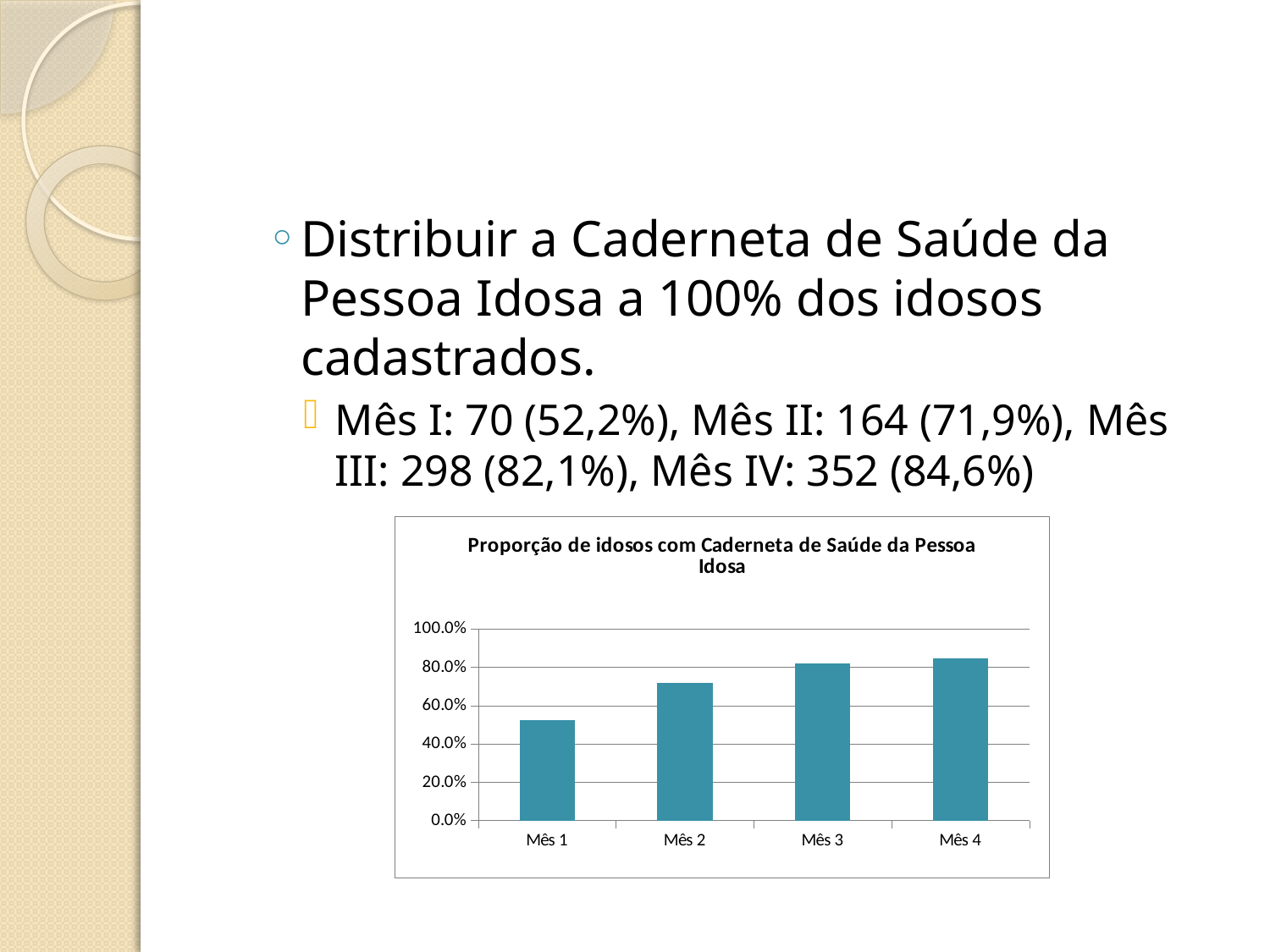
What kind of chart is shown on the slide? bar chart Is the value for Mês 2 greater or less than 60.0%? greater What is the highest value shown on the vertical axis of the chart? 100.0% Is the value for Mês 1 greater or less than 40.0%? greater Is the value for Mês 3 greater or less than 80.0%? greater What is the title of the chart? Proporção de idosos com Caderneta de Saúde da Pessoa Idosa Which is larger, the value for Mês 2 or the value for Mês 3? Mês 3 Which month has the lowest bar in the chart? Mês 1 Do the values rise or fall from Mês 1 to Mês 4? rise How many bars (months) are plotted in the chart? 4 Which month has the highest bar in the chart? Mês 4